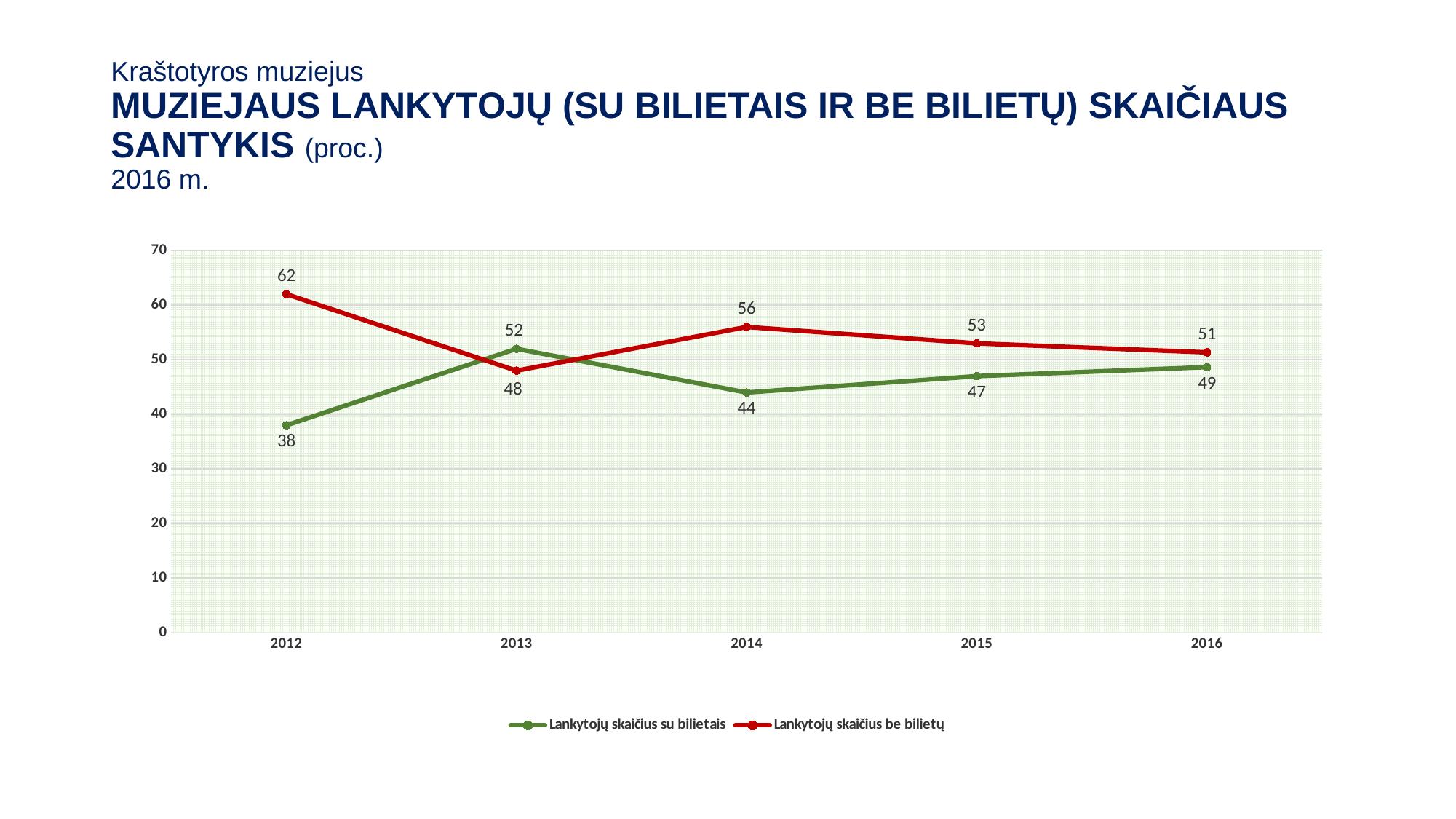
What is the value for 'Lankytojų skaičius be bilietų' in 2014? 56 What is the value for 'Lankytojų skaičius su bilietais' in 2012? 38 What kind of chart is shown on the slide? line chart In which year is 'Lankytojų skaičius su bilietais' lowest? 2012 Which series has the larger value in 2013, 'Lankytojų skaičius su bilietais' or 'Lankytojų skaičius be bilietų'? Lankytojų skaičius su bilietais What is the difference between 'Lankytojų skaičius be bilietų' and 'Lankytojų skaičius su bilietais' in 2012? 24 Is the value for 'Lankytojų skaičius be bilietų' in 2015 greater or less than 50? greater What is the value for 'Lankytojų skaičius su bilietais' in 2016? 49 In which year is 'Lankytojų skaičius be bilietų' highest? 2012 Does 'Lankytojų skaičius be bilietų' rise or fall from 2014 to 2016? fall How many years are shown on the x axis? 5 How many series does the legend list? 2